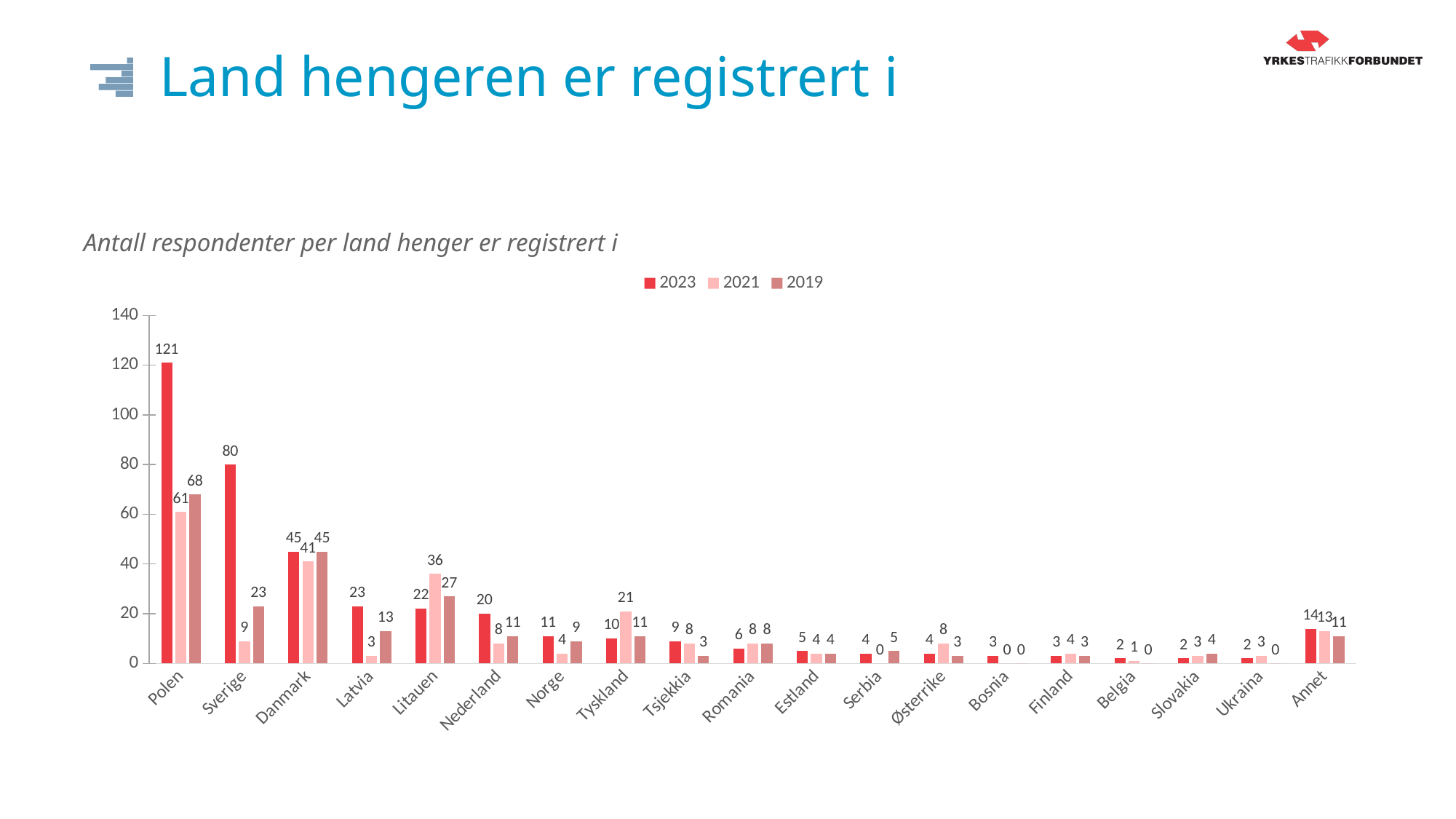
What is the difference between the 2023 and 2021 values for Sverige? 71 Which is larger for Tyskland: the 2021 value or the 2023 value? 2021 How many countries/categories are shown on the x axis? 19 What is the value for Sverige in the 2019 series? 23 Which country has the highest value in the 2023 series? Polen What is the title of the chart? Antall respondenter per land henger er registrert i What kind of chart is shown on the slide? bar chart How many series does the legend list? 3 What is the value for Polen in the 2023 series? 121 What is the value for Annet in the 2019 series? 11 Is the 2023 value for Polen greater or less than 100? greater What is the value for Litauen in the 2021 series? 36